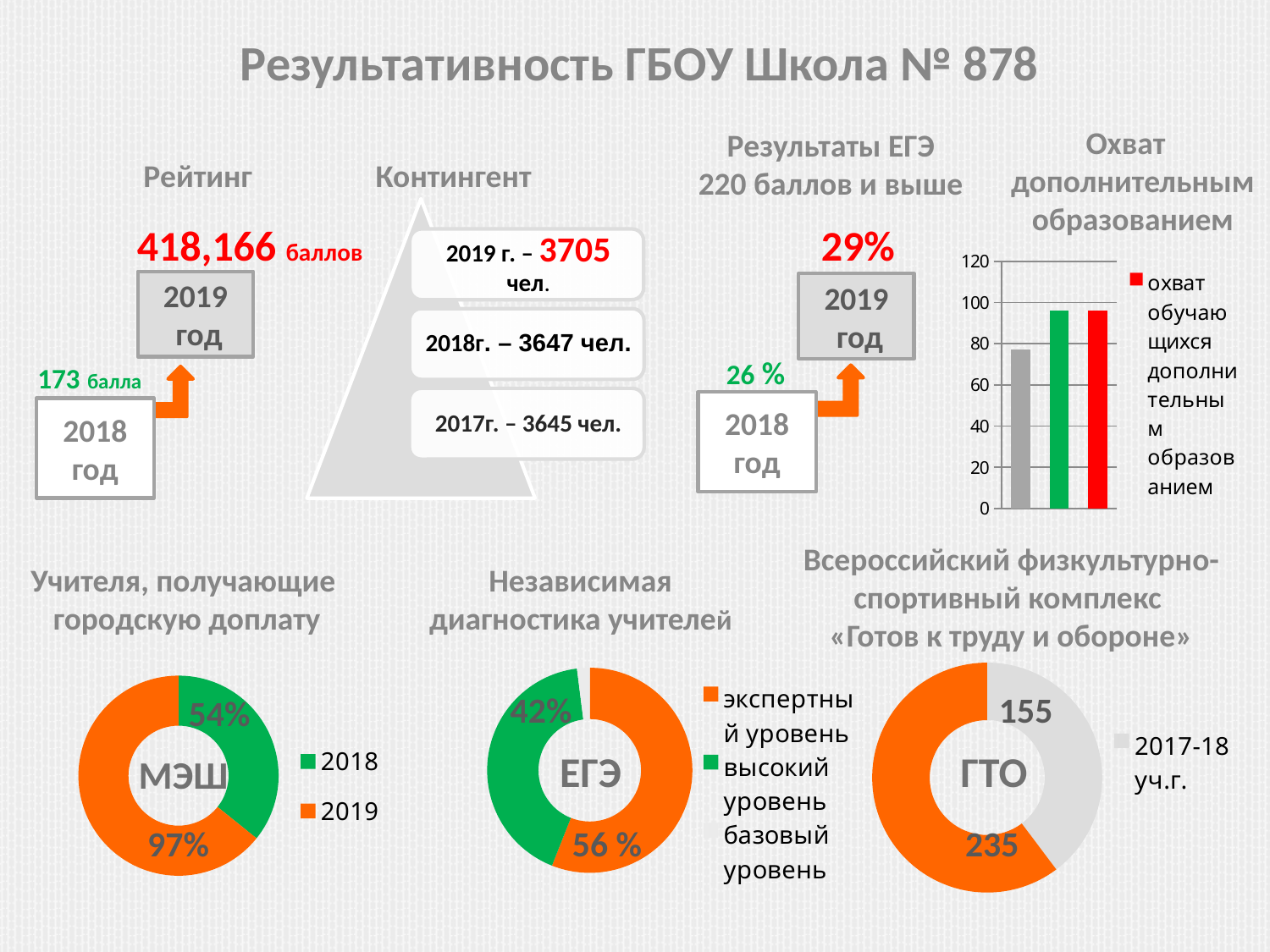
In the 'Учителя, получающие городскую доплату' (МЭШ) chart, what is the value for 2018? 54% In the 'Охват дополнительным образованием' chart, is the value of the leftmost (gray) bar greater or less than 60? greater In the 'Охват дополнительным образованием' chart, is the value of the green bar greater or less than 80? greater In the 'Учителя, получающие городскую доплату' (МЭШ) chart, what is the value for 2019? 97% What kind of chart is the 'Охват дополнительным образованием' chart? bar chart What is the highest value shown on the vertical axis of the 'Охват дополнительным образованием' chart? 120 In the 'Готов к труду и обороне' (ГТО) chart, what is the value for '2017-18 уч.г.'? 155 How many entries does the legend of the 'Независимая диагностика учителей' (ЕГЭ) chart list? 3 In the 'Учителя, получающие городскую доплату' (МЭШ) chart, which year has the larger value, 2018 or 2019? 2019 How many bars are plotted in the 'Охват дополнительным образованием' chart? 3 In the 'Охват дополнительным образованием' chart, which bar is the lowest? the leftmost (gray) bar In the 'Независимая диагностика учителей' (ЕГЭ) chart, what is the value for 'экспертный уровень'? 56 %